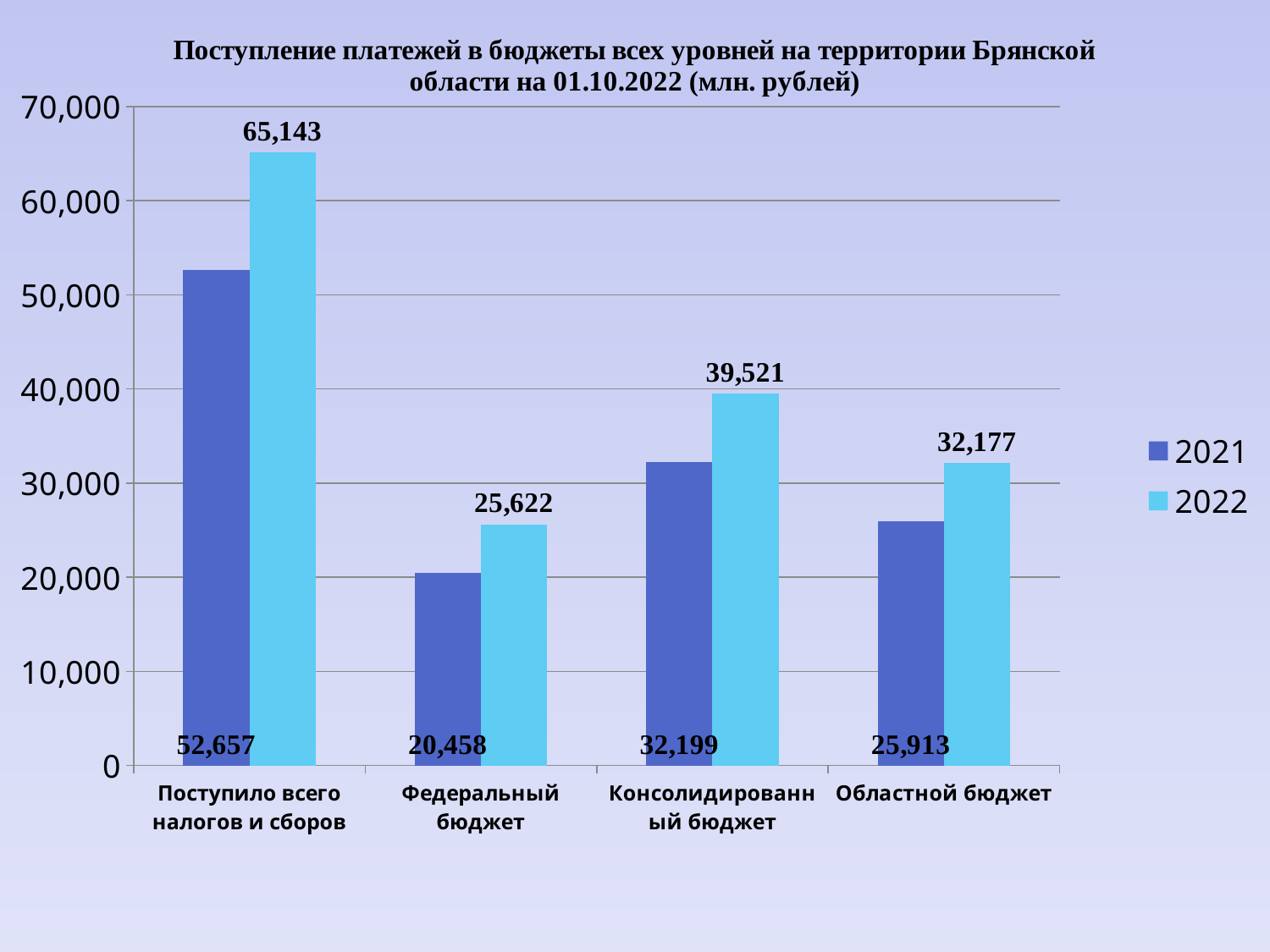
How many categories are shown on the x axis? 4 What is the 2021 value for Областной бюджет? 25,913 What is the 2022 value for Поступило всего налогов и сборов? 65,143 What is the 2021 value for Федеральный бюджет? 20,458 What is the 2022 value for Консолидированный бюджет? 39,521 Which is larger: the 2021 value for Консолидированный бюджет or the 2022 value for Областной бюджет? 2021 value for Консолидированный бюджет How many series does the legend list? 2 What is the difference between the 2022 and 2021 values for Областной бюджет? 6,264 Which category has the lowest 2021 value? Федеральный бюджет What is the difference between the 2022 and 2021 values for Поступило всего налогов и сборов? 12,486 Which category has the highest 2022 value? Поступило всего налогов и сборов What kind of chart is shown on the slide? Bar chart